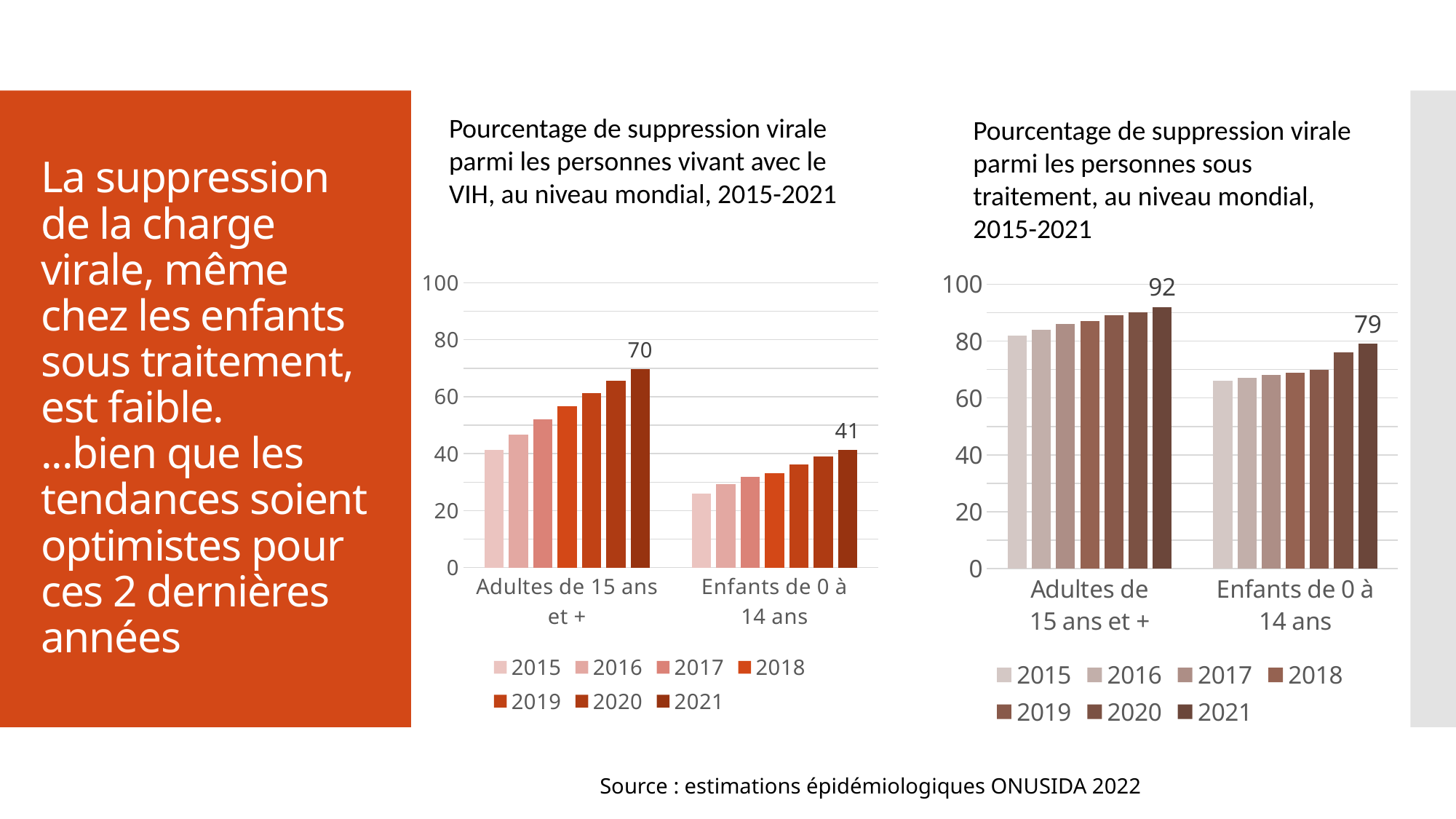
In the left chart (personnes vivant avec le VIH), is the 2015 value for Adultes de 15 ans et + greater or less than 60? less In the left chart (personnes vivant avec le VIH), what is the difference between the 2021 values for adults and children? 29 In the right chart (personnes sous traitement), what is the value for Adultes de 15 ans et + in 2021? 92 What kind of chart is the left chart (personnes vivant avec le VIH)? Bar chart In the right chart (personnes sous traitement), what is the difference between the 2021 values for adults and children? 13 In the right chart (personnes sous traitement), which category has the higher 2021 value, adults or children? Adultes de 15 ans et + In the right chart (personnes sous traitement), what is the value for Enfants de 0 à 14 ans in 2021? 79 How many categories are shown on the x axis of the right chart? 2 How many series does the legend of the left chart list? 7 In the left chart (personnes vivant avec le VIH), what is the value for Adultes de 15 ans et + in 2021? 70 In the left chart, do the values for Enfants de 0 à 14 ans rise or fall from 2015 to 2021? Rise In the left chart (personnes vivant avec le VIH), what is the value for Enfants de 0 à 14 ans in 2021? 41